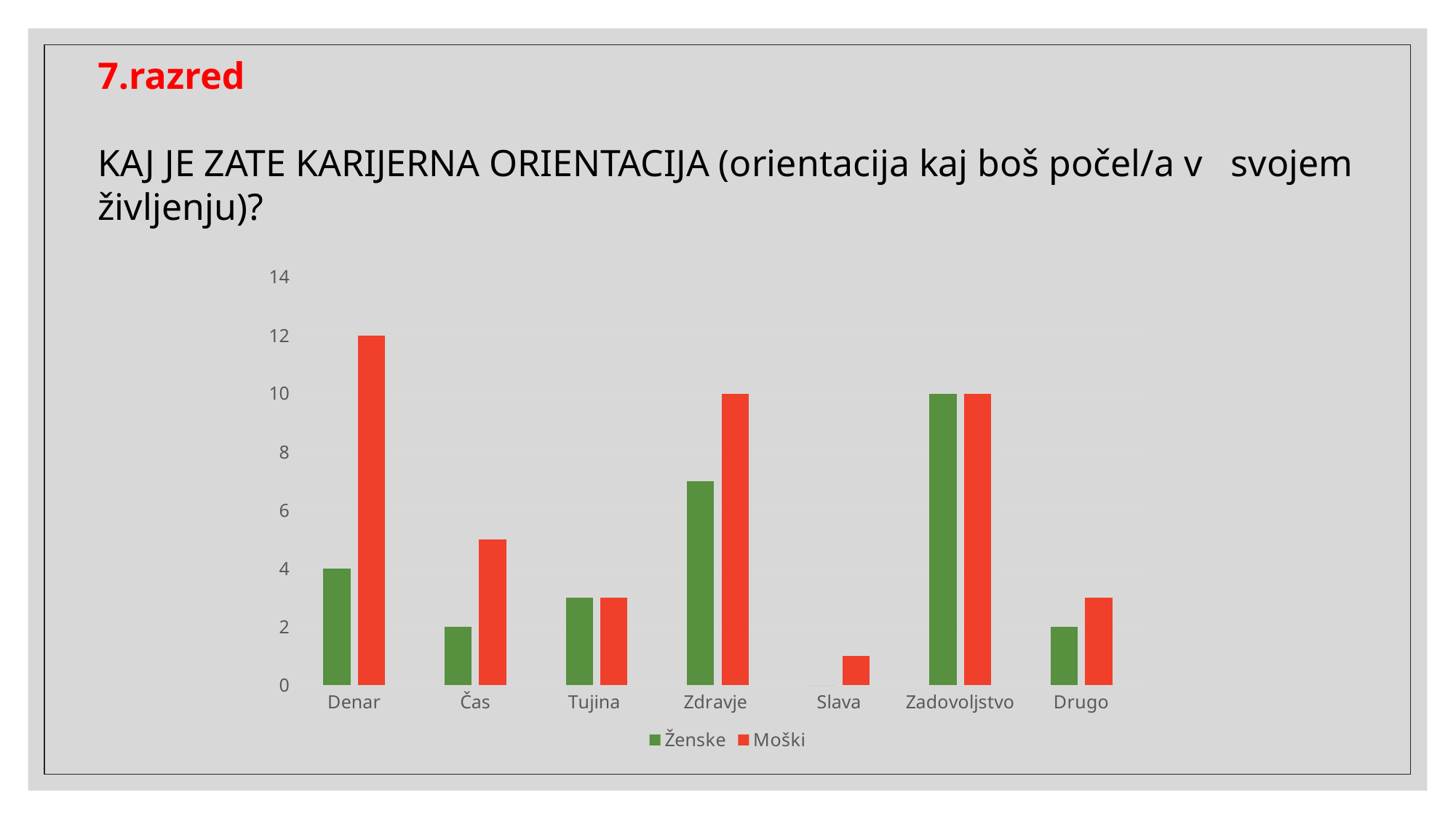
Which category has the highest value for the Moški series? Denar What is the value for Ženske in the Denar category? 4 In the Zdravje category, which series has the larger value, Ženske or Moški? Moški What is the value for Ženske in the Zadovoljstvo category? 10 What is the value for Moški in the Denar category? 12 Is the value for Ženske in the Zdravje category greater or less than 6? greater What is the difference between the Moški and Ženske values in the Denar category? 8 What is the value for Moški in the Zdravje category? 10 How many series does the legend list? 2 Which category has the lowest value for the Moški series? Slava How many categories are shown on the x axis? 7 Is the value for Moški in the Tujina category greater or less than 4? less